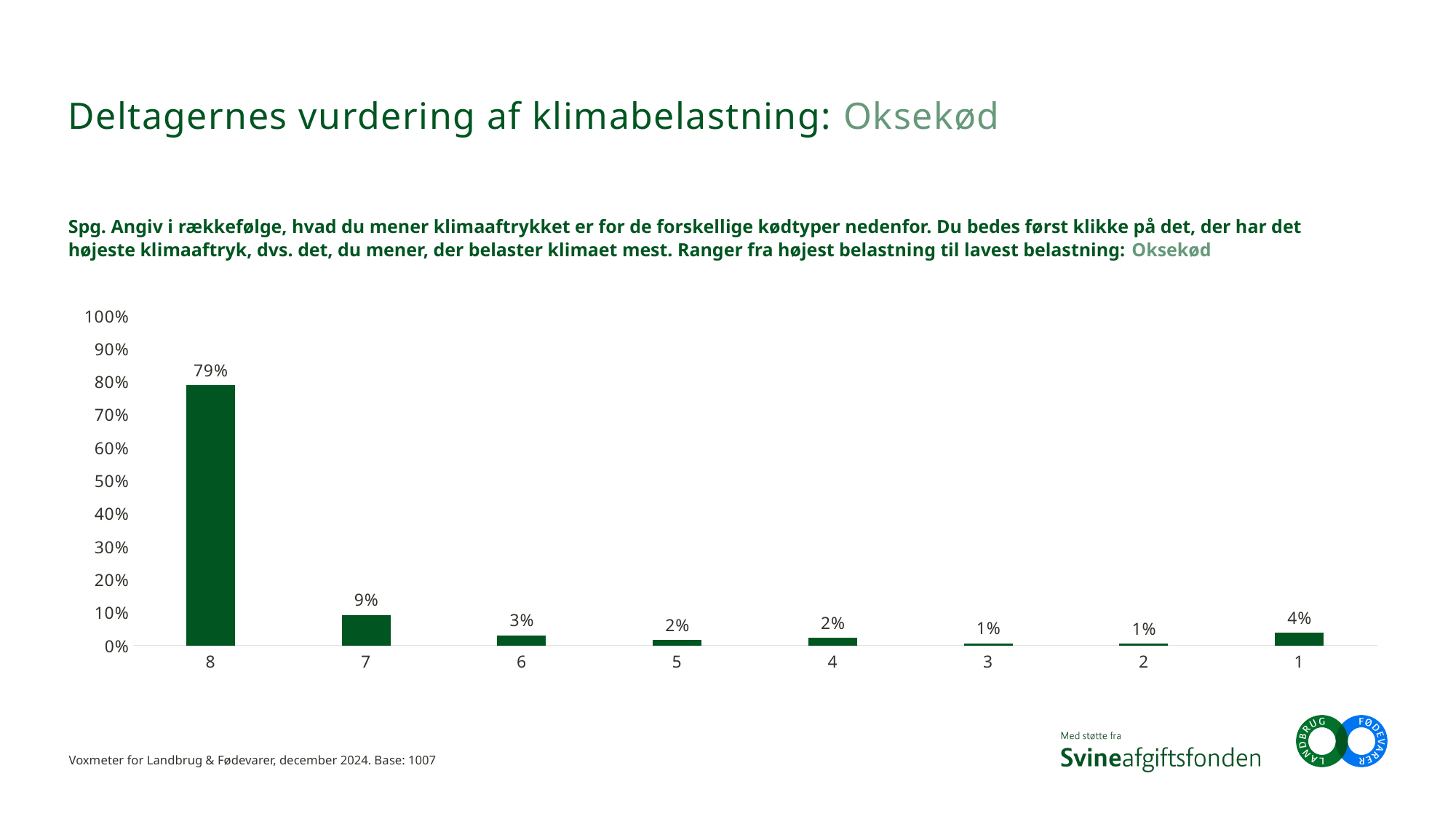
Which is larger, the value for category 1 or the value for category 6? 1 What is the value for category 1? 4% What is the value for category 7? 9% What kind of chart is shown on the slide? bar chart What is the value for category 6? 3% What is the value for category 8? 79% What is the highest value shown on the y axis? 100% What is the difference between the values for category 7 and category 1? 5% How many categories are shown on the x axis? 8 Which category has the highest value? 8 What is the difference between the values for category 8 and category 7? 70% Is the value for category 8 greater or less than 70%? greater